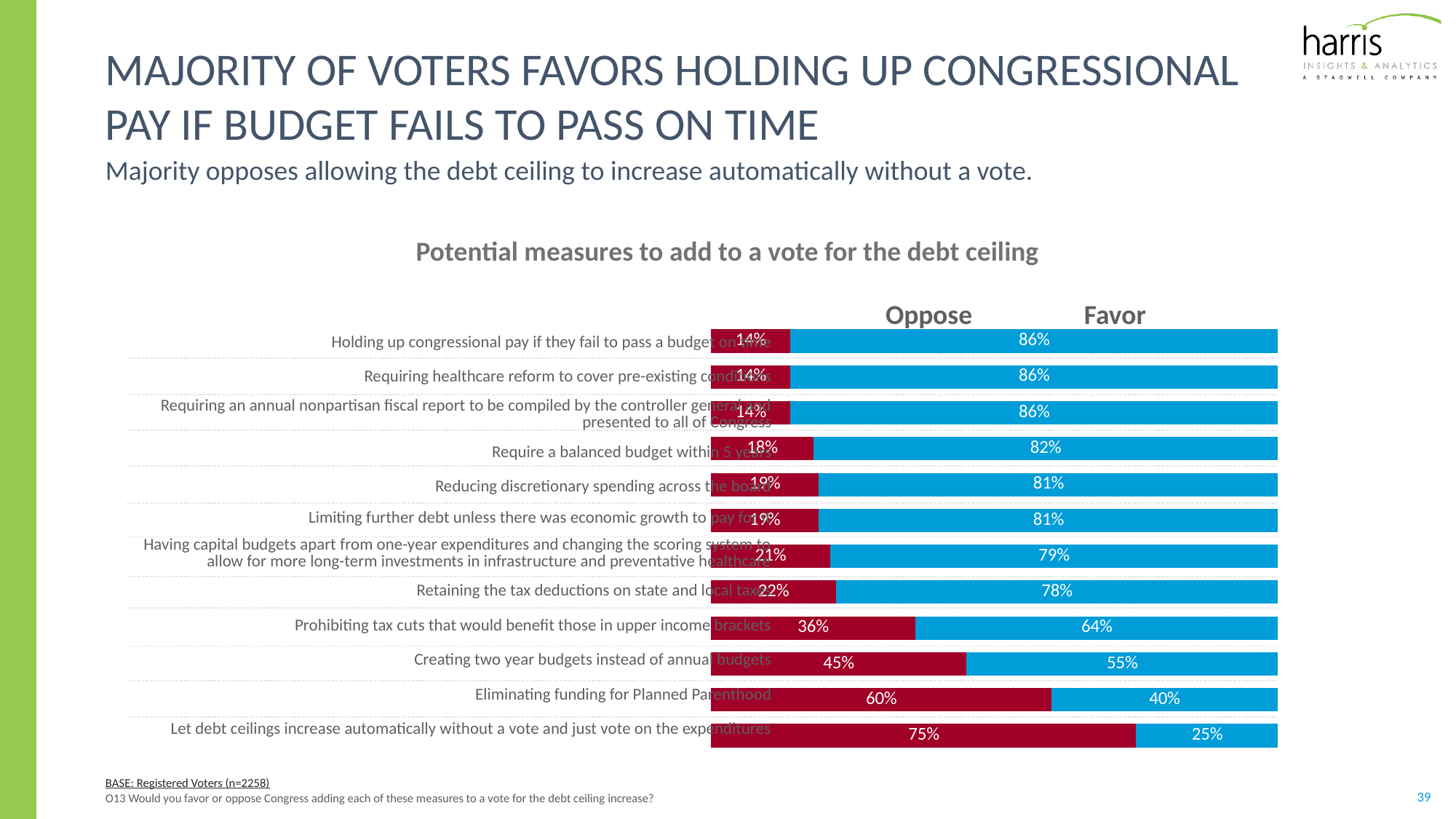
What is the total of the Oppose and Favor percentages for requiring a balanced budget within 5 years? 100% What percentage of voters favor holding up congressional pay if they fail to pass a budget on time? 86% What percentage of voters favor creating two year budgets instead of annual budgets? 55% What type of chart is shown on the slide? Stacked bar chart What percentage of voters oppose eliminating funding for Planned Parenthood? 60% How many measures are listed in the chart? 12 Which measure has the lowest Favor percentage? Let debt ceilings increase automatically without a vote and just vote on the expenditures How many series does the chart show? 2 What is the difference between the Favor and Oppose percentages for prohibiting tax cuts that would benefit those in upper income brackets? 28% Which measure has the highest Oppose percentage? Let debt ceilings increase automatically without a vote and just vote on the expenditures Which is larger for retaining the tax deductions on state and local taxes: the Oppose or the Favor percentage? Favor What is the title of the chart? Potential measures to add to a vote for the debt ceiling